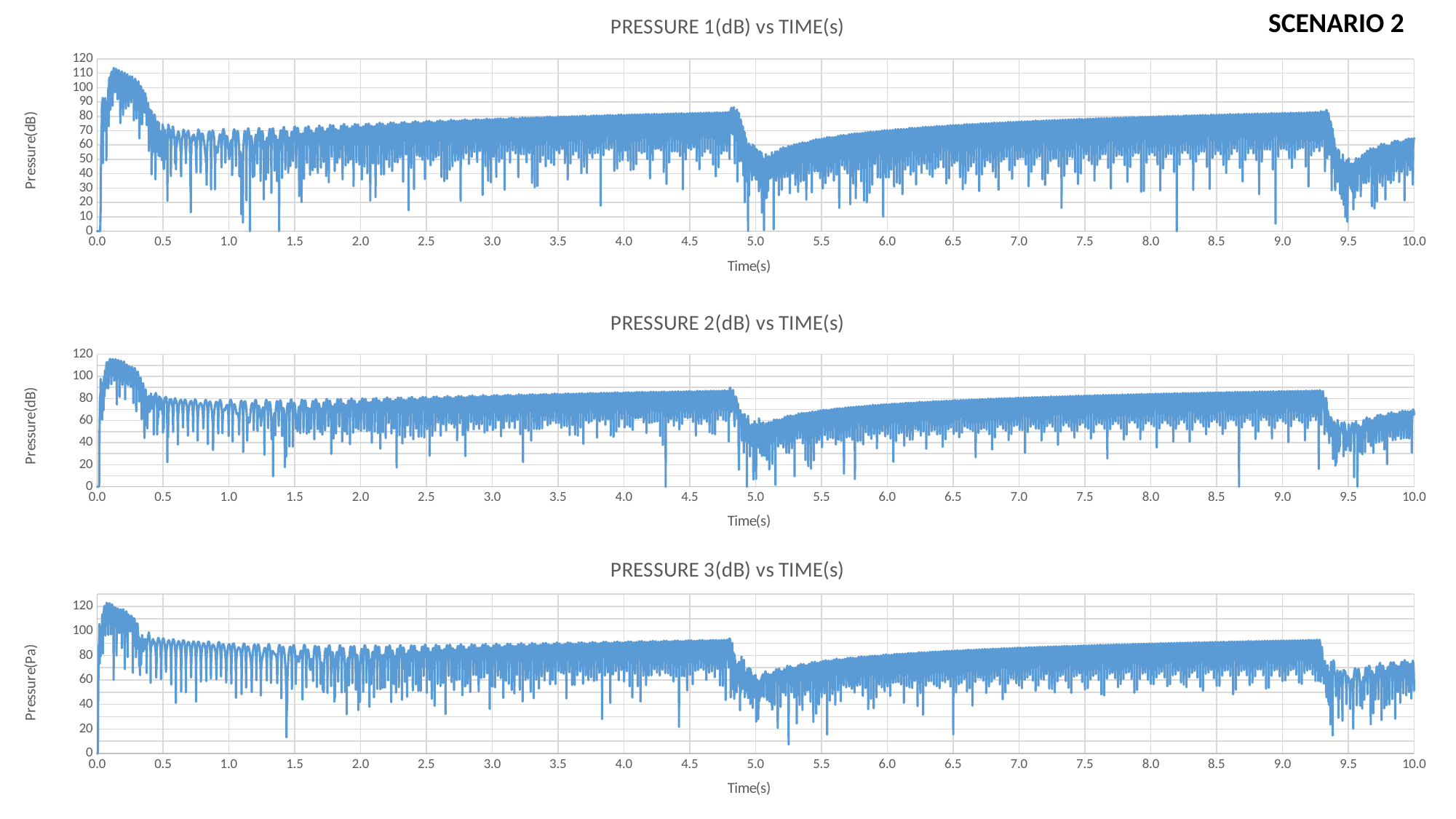
What is the x-axis title of the 'PRESSURE 2(dB) vs TIME(s)' chart? Time(s) In the 'PRESSURE 1(dB) vs TIME(s)' chart, does the signal rise or fall between 0.2 s and 0.5 s? fall Which of the three charts reaches the highest peak value? PRESSURE 3(dB) vs TIME(s) In the 'PRESSURE 1(dB) vs TIME(s)' chart, is the upper envelope of the signal at 9.5 s greater or less than 80? less How many charts are shown on the slide? 3 In the 'PRESSURE 1(dB) vs TIME(s)' chart, is the peak value near 0.1 s greater or less than 100? greater In the 'PRESSURE 2(dB) vs TIME(s)' chart, is the highest value reached greater or less than 100? greater What is the y-axis label of the 'PRESSURE 3(dB) vs TIME(s)' chart? Pressure(Pa) What kind of chart is 'PRESSURE 1(dB) vs TIME(s)'? line chart In the 'PRESSURE 1(dB) vs TIME(s)' chart, does the upper envelope of the signal rise or fall between 5.5 s and 9.0 s? rise